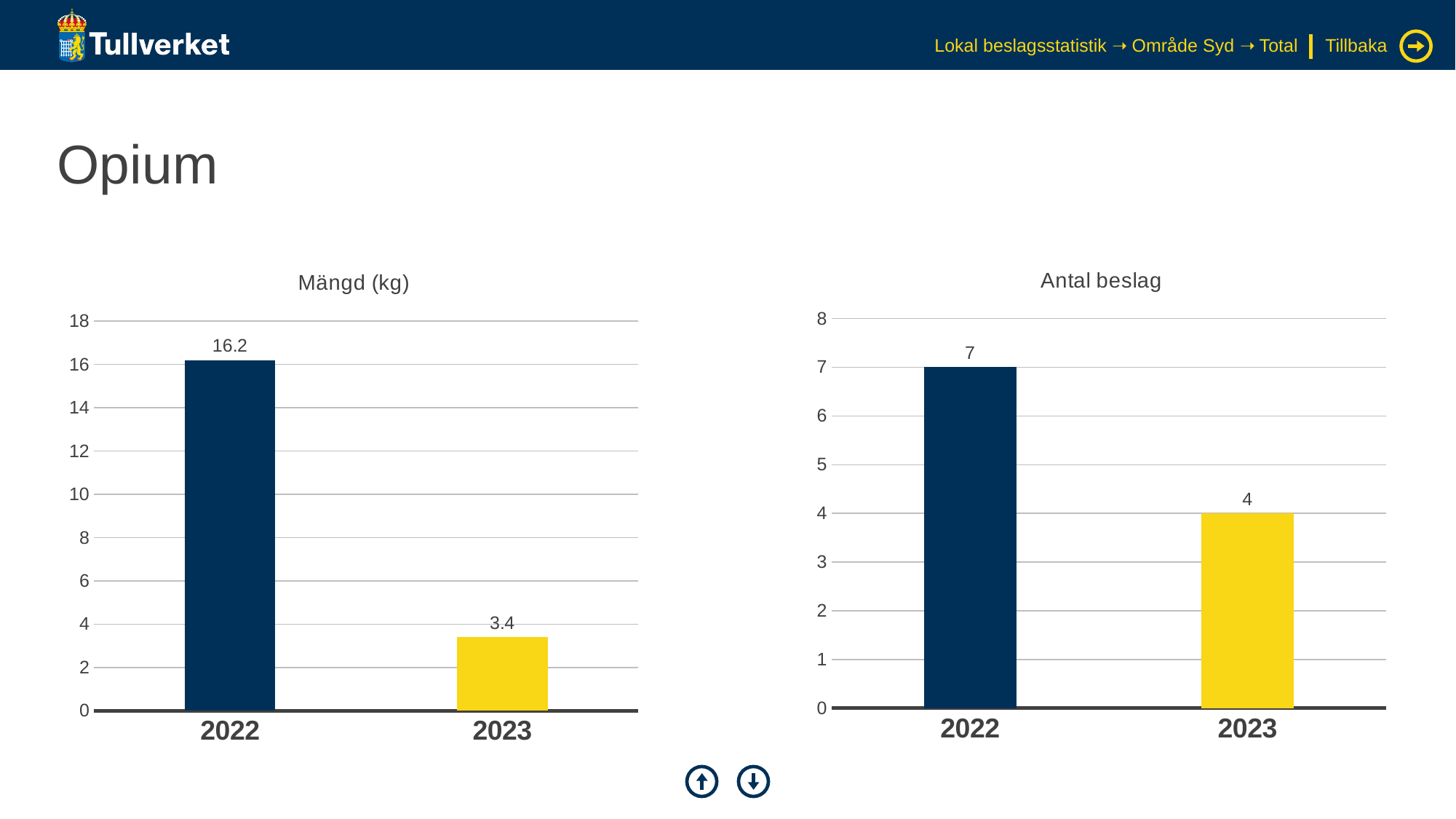
In the 'Antal beslag' chart, what is the value for 2022? 7 In the 'Antal beslag' chart, which is larger, the value for 2022 or 2023? 2022 In the 'Antal beslag' chart, which year has the lowest value? 2023 In the 'Mängd (kg)' chart, what is the value for 2023? 3.4 In the 'Mängd (kg)' chart, do the values rise or fall from 2022 to 2023? Fall In the 'Mängd (kg)' chart, which year has the highest value? 2022 In the 'Mängd (kg)' chart, what is the difference between the 2022 and 2023 values? 12.8 In the 'Antal beslag' chart, what is the value for 2023? 4 What kind of chart is the 'Antal beslag' chart? Bar chart How many categories are shown on the x axis of the 'Mängd (kg)' chart? 2 In the 'Mängd (kg)' chart, what is the value for 2022? 16.2 In the 'Antal beslag' chart, what is the difference between the 2022 and 2023 values? 3